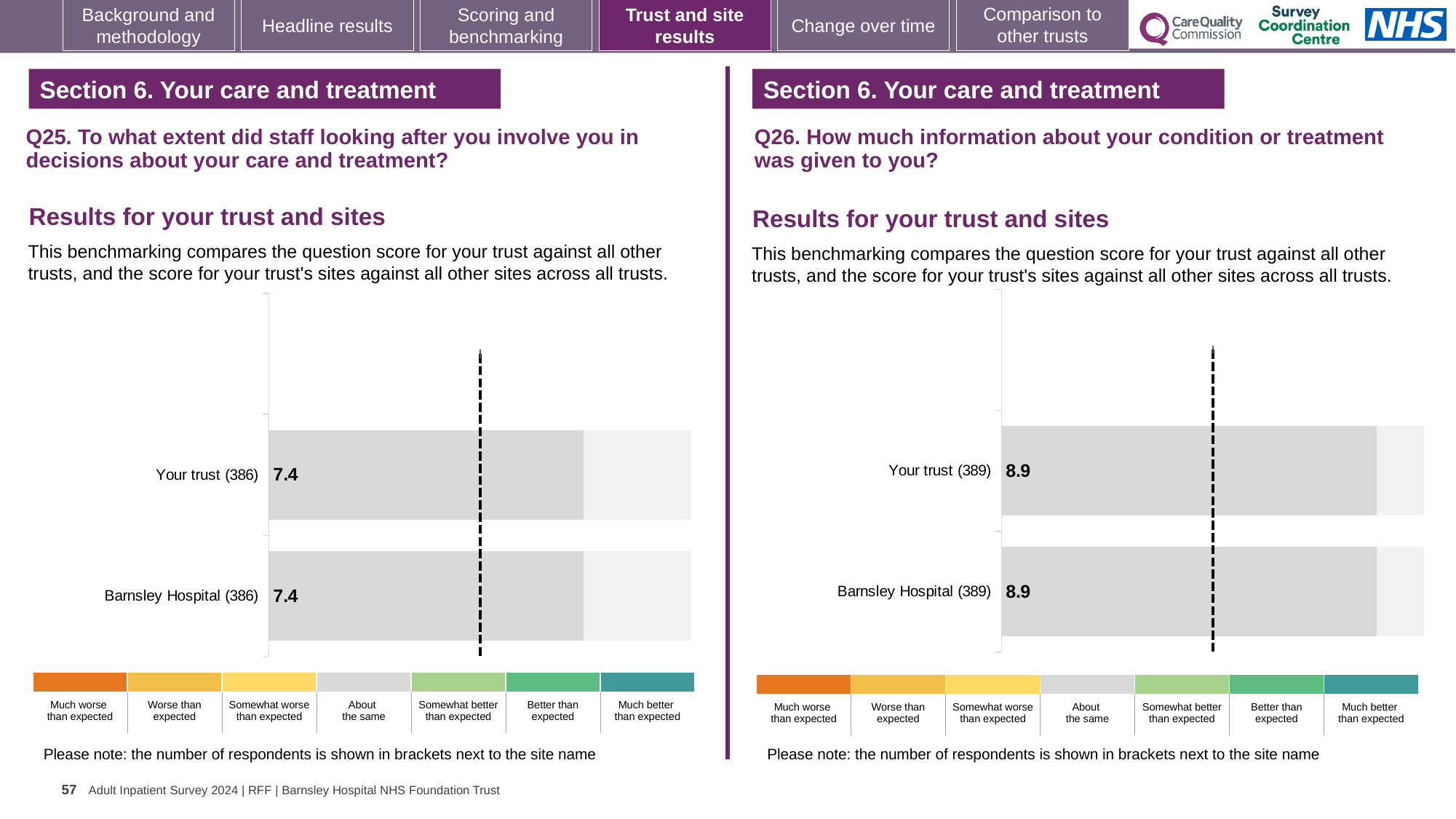
On the Q25 chart (left), what is the score for Barnsley Hospital? 7.4 On the Q26 chart (right), what is the score for Barnsley Hospital? 8.9 How many bars are plotted on the Q25 chart (left)? 2 On the Q25 chart (left), what is the difference between the Your trust score and the Barnsley Hospital score? 0 How many bars are plotted on the Q26 chart (right)? 2 On the Q25 chart (left), what is the score for Your trust? 7.4 On the Q25 chart (left), how many respondents are shown in brackets next to Barnsley Hospital? 386 Is the Your trust score on the Q26 chart (right) larger or smaller than the Your trust score on the Q25 chart (left)? Larger On the Q26 chart (right), what is the score for Your trust? 8.9 What type of chart is used on the Q26 chart (right)? Bar chart On the Q26 chart (right), how many respondents are shown in brackets next to Your trust? 389 On the Q26 chart (right), what is the difference between the Your trust score and the Barnsley Hospital score? 0